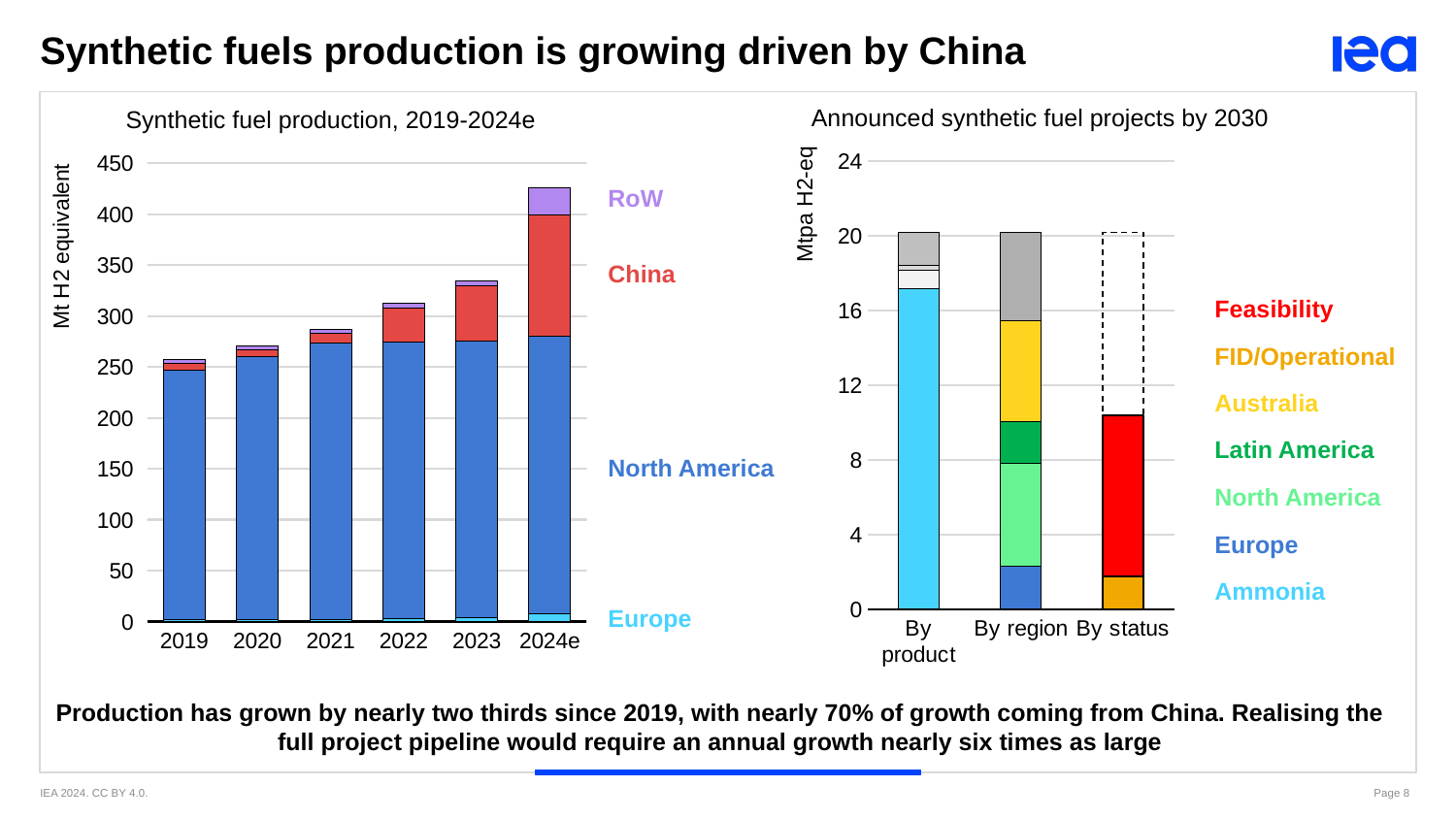
In the left chart, 'Synthetic fuel production, 2019-2024e', how many series does the legend list? 4 In the right chart, 'Announced synthetic fuel projects by 2030', is the 'By product' bar greater or less than 16? greater What is the y-axis label of the left chart, 'Synthetic fuel production, 2019-2024e'? Mt H2 equivalent In the left chart, 'Synthetic fuel production, 2019-2024e', which year has the highest total production? 2024e In the left chart, 'Synthetic fuel production, 2019-2024e', does total production rise or fall from 2019 to 2024e? Rise In the right chart, 'Announced synthetic fuel projects by 2030', how many bars are shown on the x axis? 3 In the left chart, 'Synthetic fuel production, 2019-2024e', which series forms the largest part of each bar? North America In the left chart, 'Synthetic fuel production, 2019-2024e', how many years are shown on the x axis? 6 What kind of chart is the left chart, 'Synthetic fuel production, 2019-2024e'? Stacked bar chart In the left chart, 'Synthetic fuel production, 2019-2024e', which year has the lowest total production? 2019 In the left chart, 'Synthetic fuel production, 2019-2024e', is the total for 2024e greater or less than 400? greater In the left chart, 'Synthetic fuel production, 2019-2024e', is the total for 2019 greater or less than 300? less